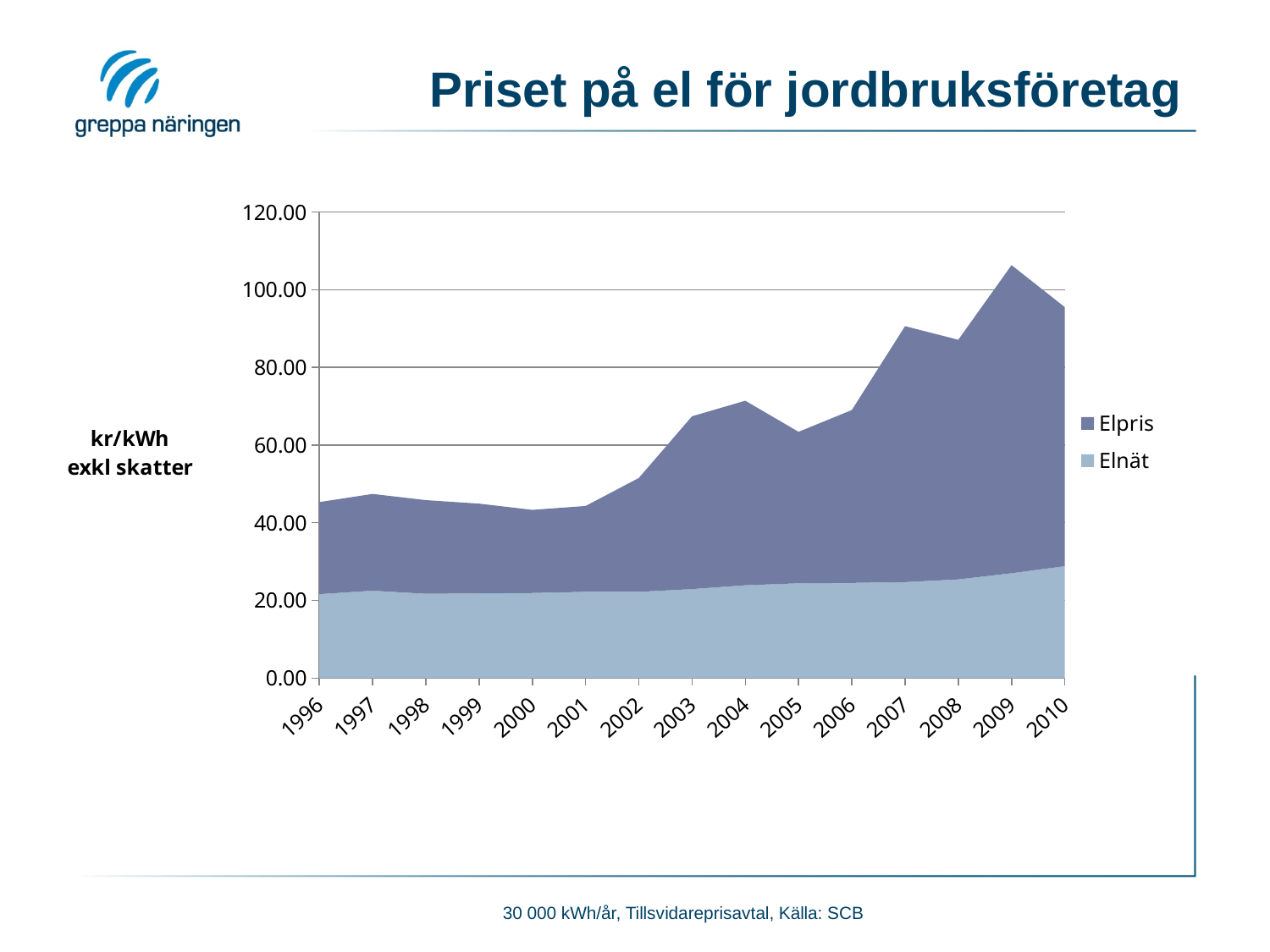
Does the total price generally rise or fall from 1996 to 2010? rise What is the title of the chart on the slide? Priset på el för jordbruksföretag What kind of chart is shown on the slide? Stacked area chart Is the total value for 1996 greater or less than 60.00? less In which year does the total (Elpris plus Elnät) reach its highest value? 2009 Is the total value for 2007 greater or less than 80.00? greater Is the total value for 2009 greater or less than 100.00? greater How many series does the legend list? 2 Which series are listed in the legend? Elpris and Elnät How many years are shown on the x axis? 15